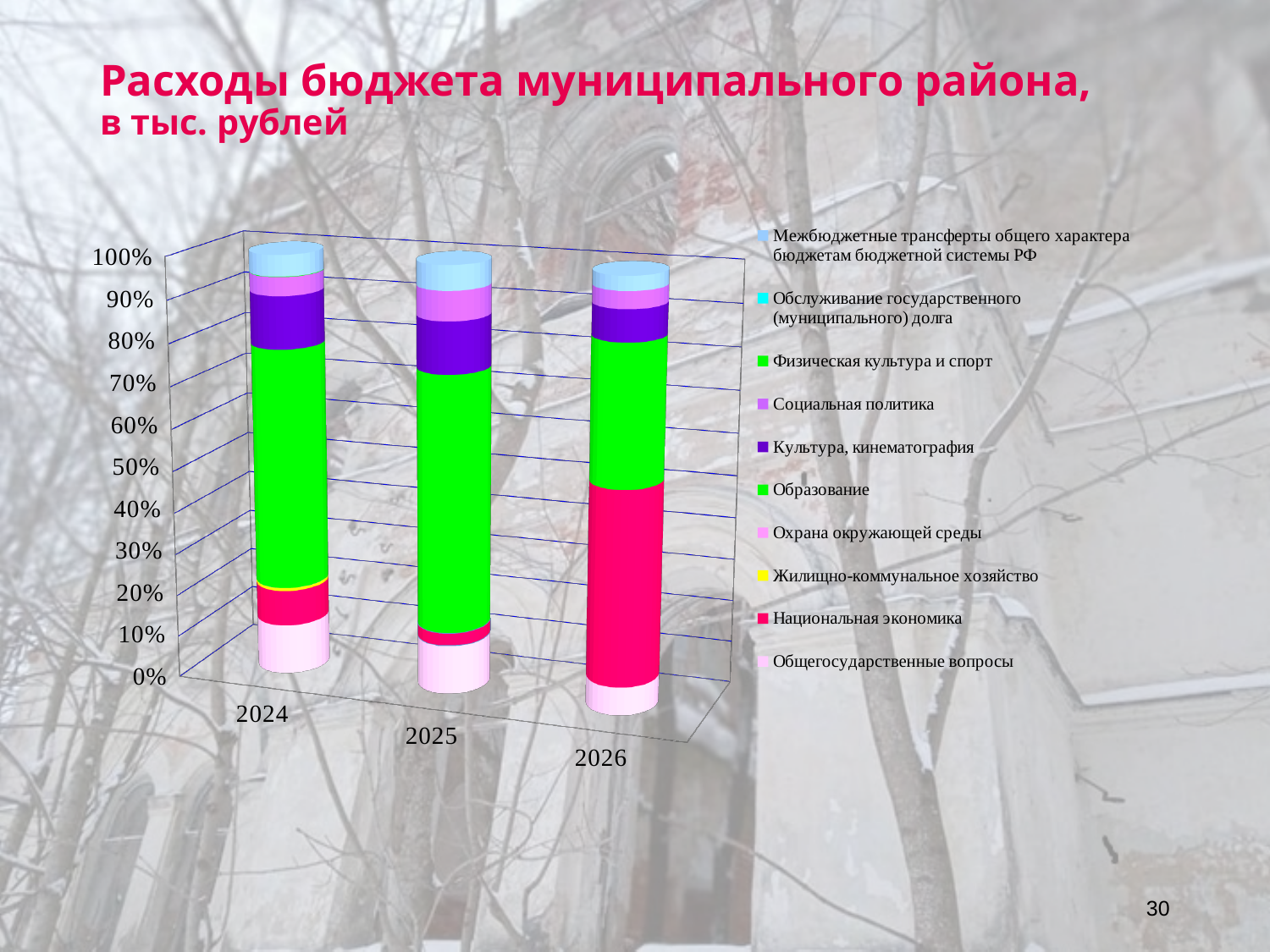
Is the share of Образование larger in 2025 or in 2026? 2025 What is the title of the chart on the slide? Расходы бюджета муниципального района, в тыс. рублей Is the share of Национальная экономика in 2026 greater or less than 30%? greater Which series takes the largest share of the 2025 bar? Образование In which year does Национальная экономика have the largest share of the bar? 2026 Is the share of Национальная экономика larger in 2024 or in 2026? 2026 In which year does Образование have the largest share of the bar? 2025 In which year does Национальная экономика have the smallest share of the bar? 2025 How many series does the chart legend list? 10 What kind of chart is shown on the slide? Stacked bar chart How many years are shown on the x axis of the chart? 3